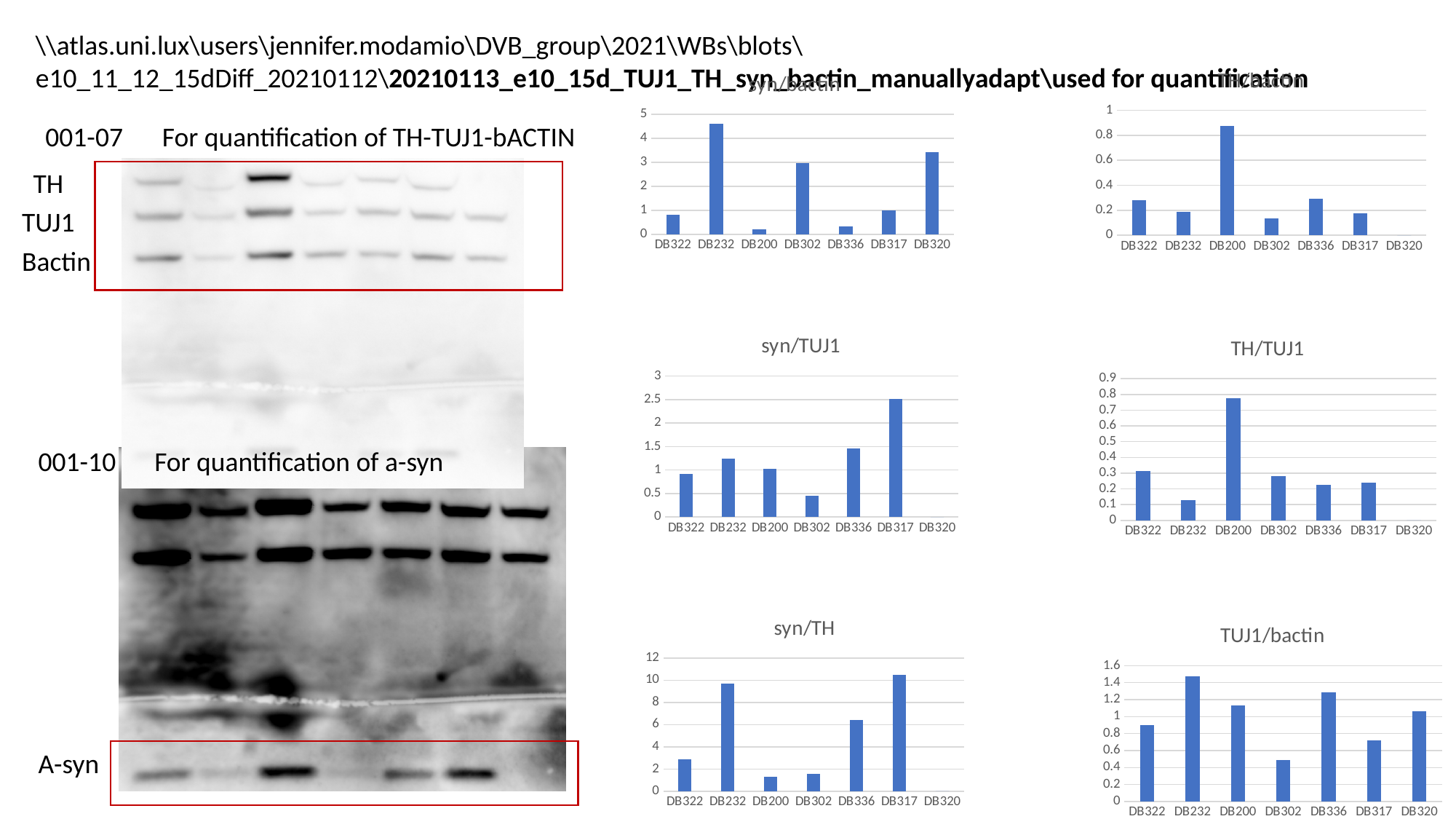
In the syn/TH chart, how many bars are plotted? 6 In the TH/bactin chart (top right), is the value for DB302 greater or less than 0.2? less In the syn/bactin chart, is the value for DB232 greater or less than 4? greater In the syn/bactin chart, which category has the highest value? DB232 In the syn/bactin chart, which category has the lowest value? DB200 In the syn/TUJ1 chart, which is larger, the value for DB336 or the value for DB232? DB336 In the syn/TUJ1 chart, which category has the highest value? DB317 What type of chart is the TUJ1/bactin chart? Bar chart In the TUJ1/bactin chart, which category has the lowest value? DB302 In the syn/TH chart, is the value for DB317 greater or less than 10? greater In the TH/bactin chart (top right), which category has the highest value? DB200